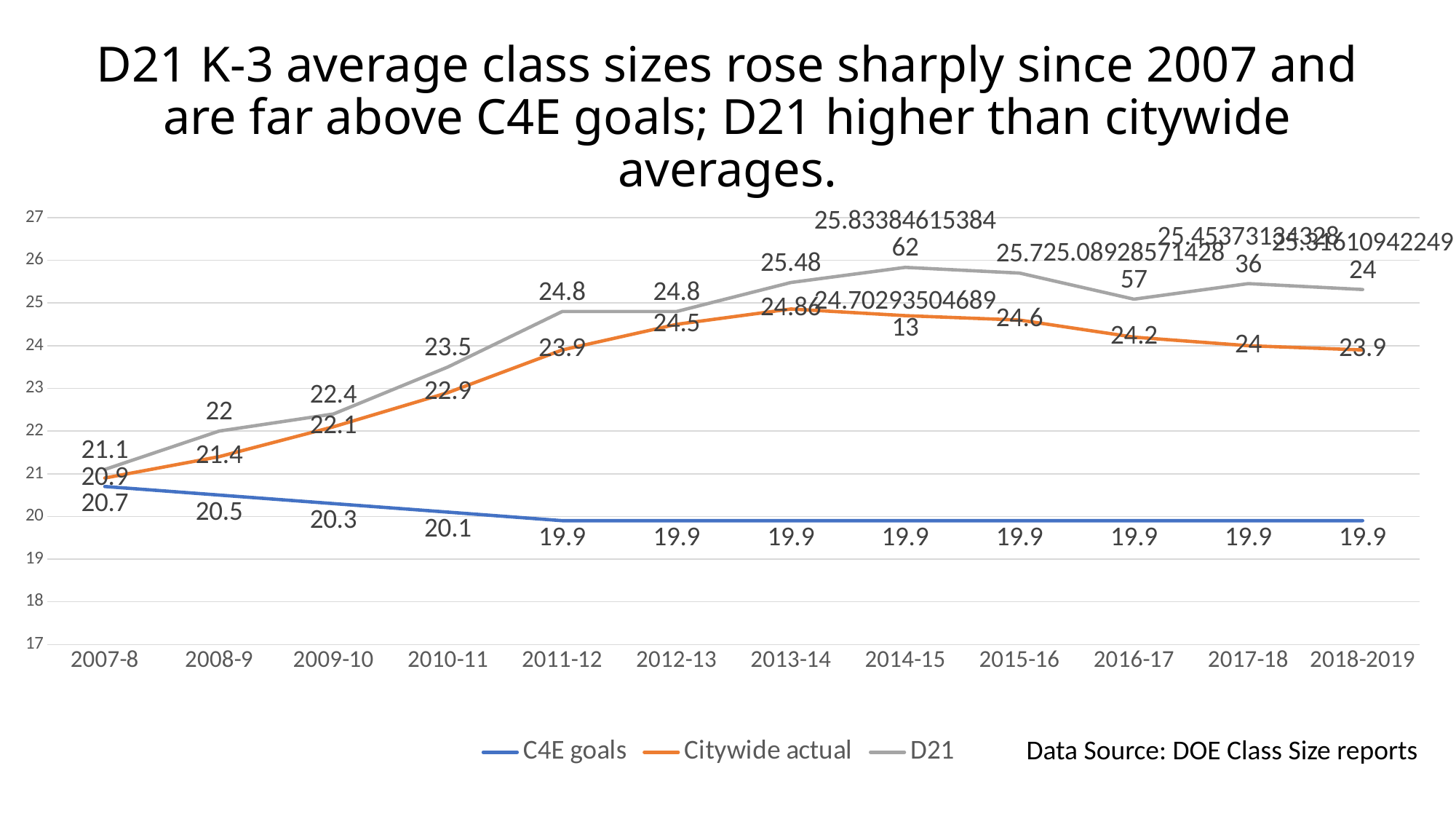
What colour is the D21 line in the legend? gray How many school years are plotted along the x axis? 12 What is the D21 value for 2010-11? 23.5 In 2008-9, which is larger: the D21 value or the Citywide actual value? D21 Does the Citywide actual line rise or fall from 2007-8 to 2013-14? rise What is the C4E goals value for 2009-10? 20.3 Which school year has the lowest Citywide actual value? 2007-8 How many series does the legend list? 3 What is the Citywide actual value for 2012-13? 24.5 What kind of chart is shown on the slide? line chart What is the difference between the D21 value and the Citywide actual value in 2011-12? 0.9 Is the D21 value for 2014-15 greater or less than 25? greater